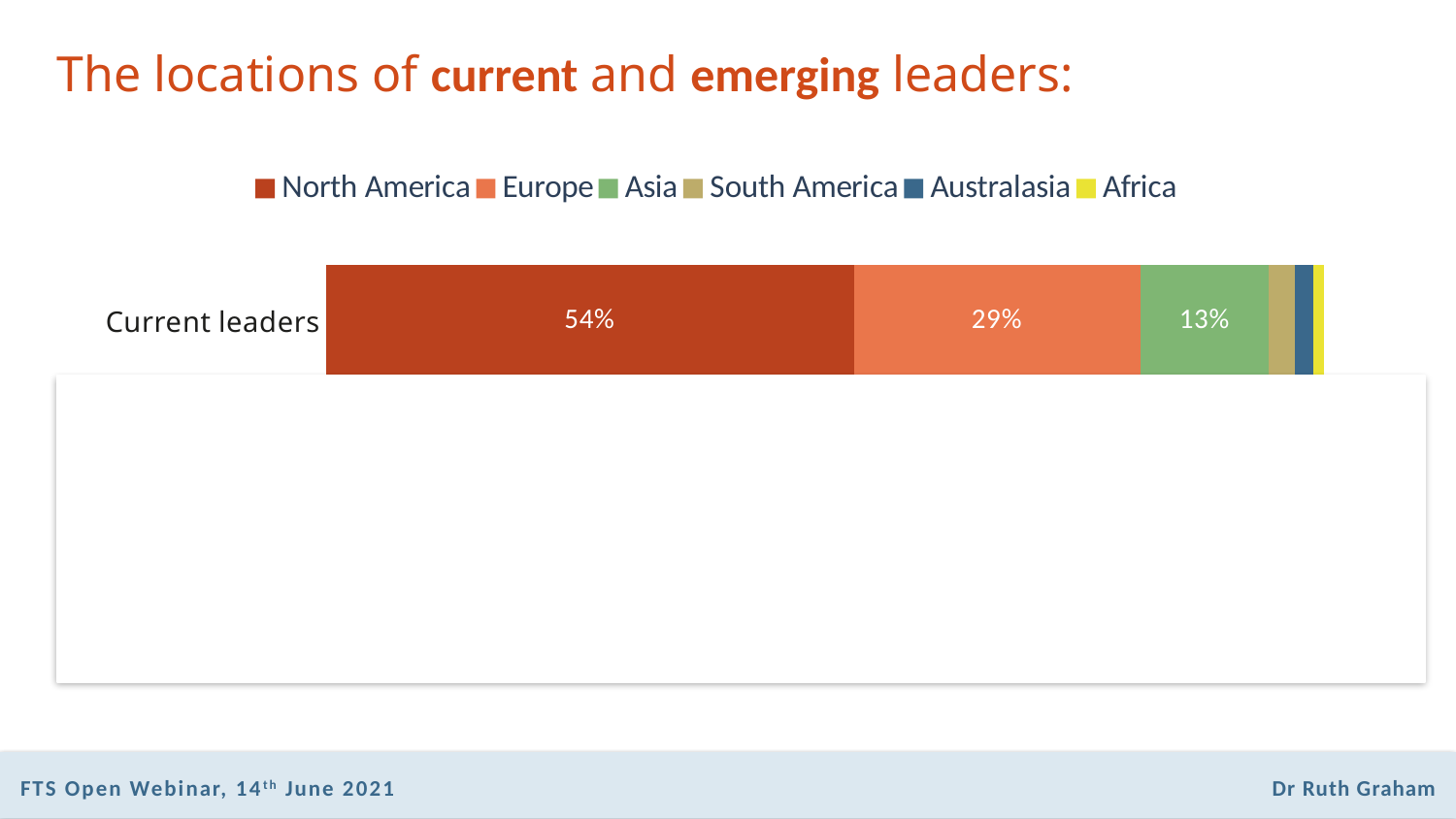
What percentage of current leaders are located in Asia? 13% What kind of chart is shown on the slide? Stacked bar chart Which region accounts for the largest share of current leaders? North America By how many percentage points does the Europe share of current leaders exceed the Asia share? 16 percentage points By how many percentage points does the North America share of current leaders exceed the Europe share? 25 percentage points How many regions does the legend list? 6 What is the label of the bar shown on the chart? Current leaders Which region is listed last in the legend? Africa Which region is shown in dark red in the legend? North America What percentage of current leaders are located in North America? 54% What percentage of current leaders are located in Europe? 29% Which is larger for current leaders: the share in Europe or the share in Asia? Europe